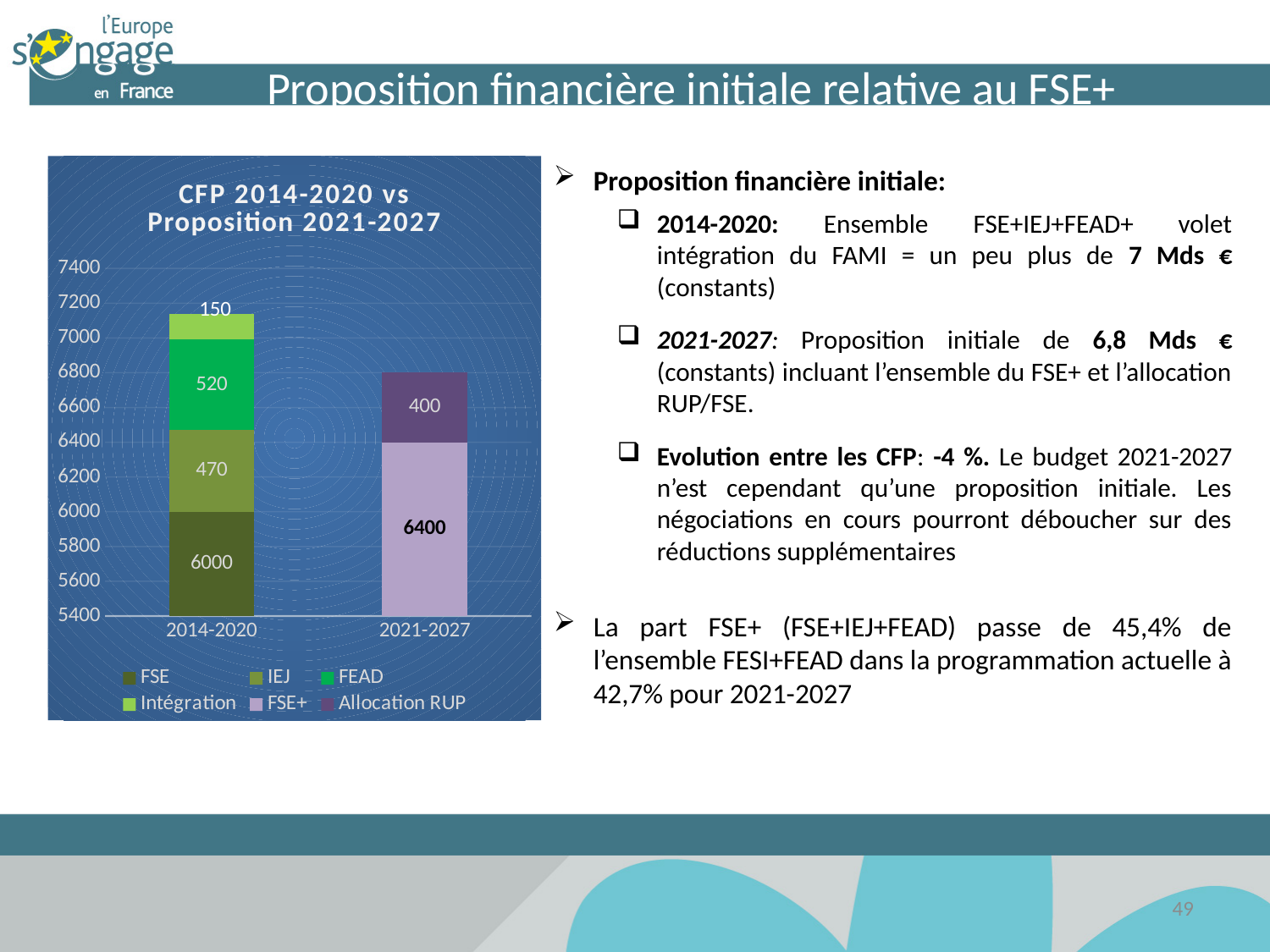
What is the value of the Intégration segment for 2014-2020? 150 How many categories are shown on the x axis of the chart? 2 What type of chart is shown on the slide? Stacked bar chart What is the value of the FEAD segment for 2014-2020? 520 What is the value of the IEJ segment for 2014-2020? 470 How many series does the chart legend list? 6 What is the title of the chart? CFP 2014-2020 vs Proposition 2021-2027 What is the total of the stacked bar for 2021-2027? 6800 What is the value of the Allocation RUP segment for 2021-2027? 400 What is the value of the FSE segment for 2014-2020? 6000 Which is larger, the FEAD segment or the IEJ segment in the 2014-2020 bar? FEAD What is the value of the FSE+ segment for 2021-2027? 6400